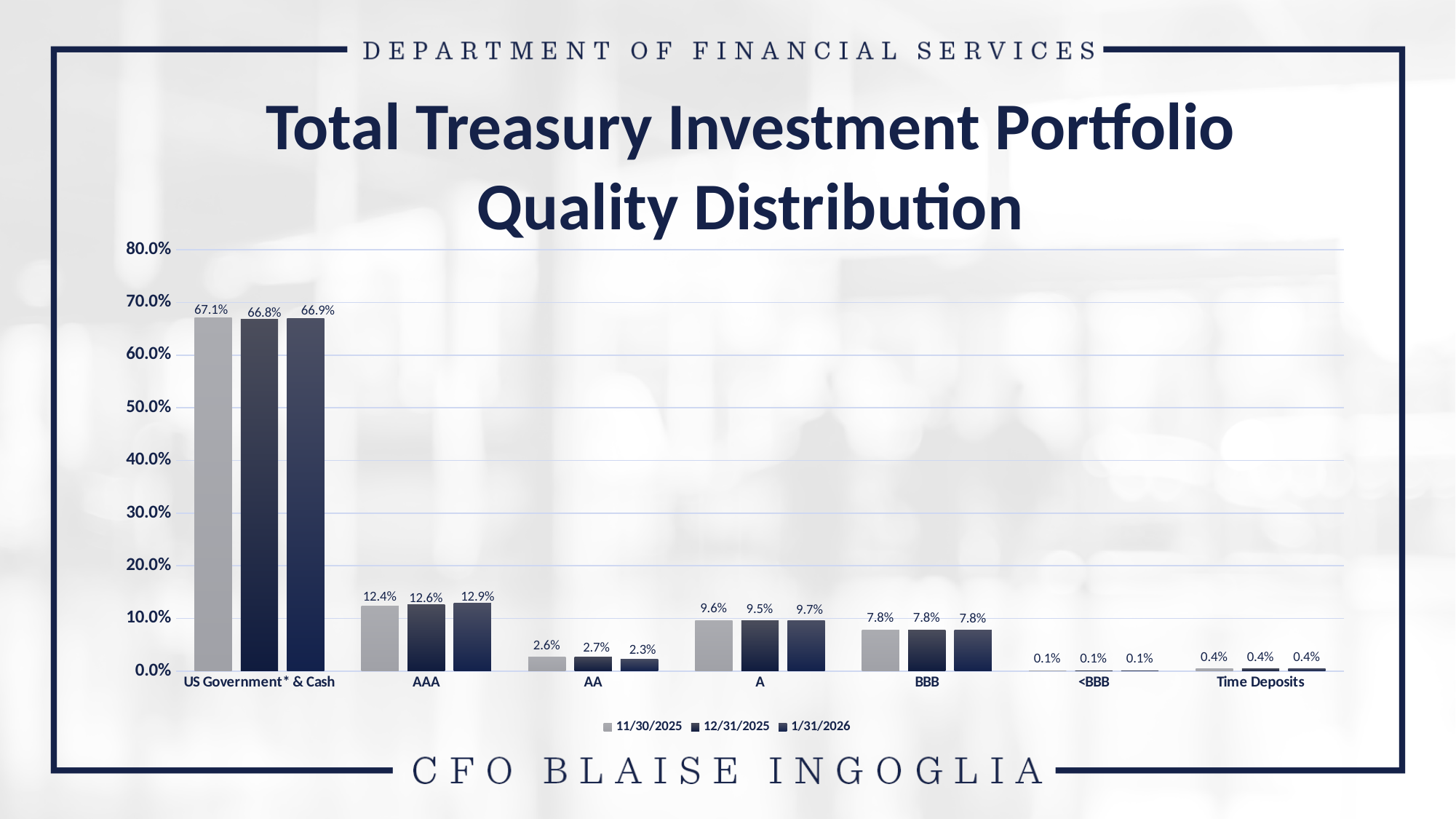
Which category has the lowest value for the 11/30/2025 series? <BBB Which category has the highest value for the 1/31/2026 series? US Government* & Cash Which is larger for the A category: the 11/30/2025 value or the 1/31/2026 value? 1/31/2026 What is the title of the chart? Total Treasury Investment Portfolio Quality Distribution What is the difference between the 1/31/2026 and 11/30/2025 values for AAA? 0.5% What is the value for Time Deposits for the 1/31/2026 series? 0.4% What is the value for AA for the 12/31/2025 series? 2.7% How many series does the legend list? 3 How many categories are shown on the x axis? 7 What kind of chart is shown on the slide? Bar chart What is the value for US Government* & Cash for the 11/30/2025 series? 67.1% What is the value for AAA for the 1/31/2026 series? 12.9%